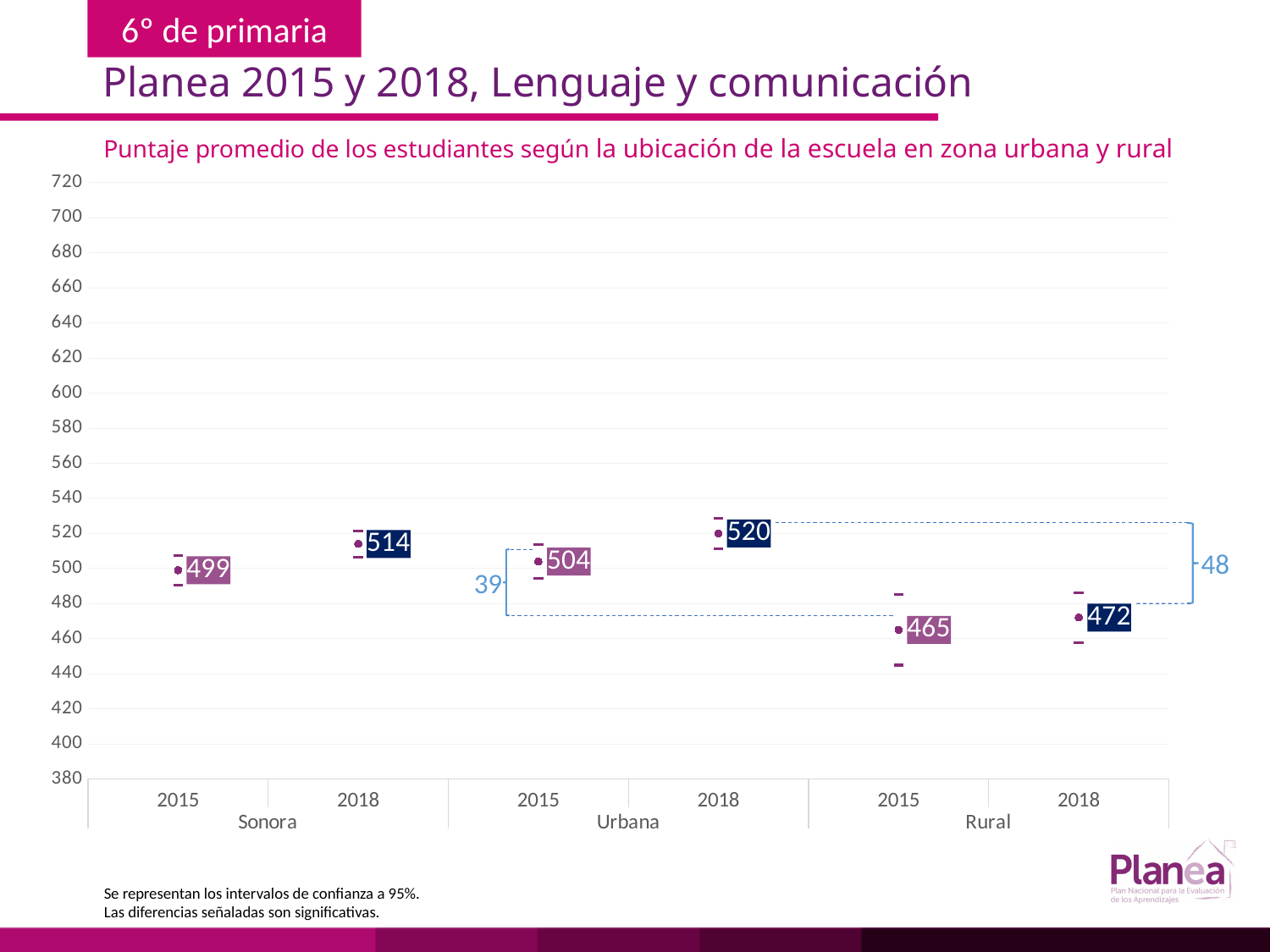
Which point has the highest average score? Urbana 2018 Which point has the lowest average score? Rural 2015 What is the difference between the Urbana and Rural scores in 2018? 48 Which is larger, the Urbana 2015 score or the Sonora 2015 score? Urbana 2015 What is the average score for Sonora in 2015? 499 What is the average score for Rural in 2018? 472 Do the scores rise or fall from 2015 to 2018 in each of the three groups? rise What is the average score for Urbana in 2018? 520 How many data points are plotted on the chart? 6 Is the Rural 2018 score greater or less than 480? less What is the difference between the Sonora scores in 2018 and 2015? 15 What is the average score for Rural in 2015? 465